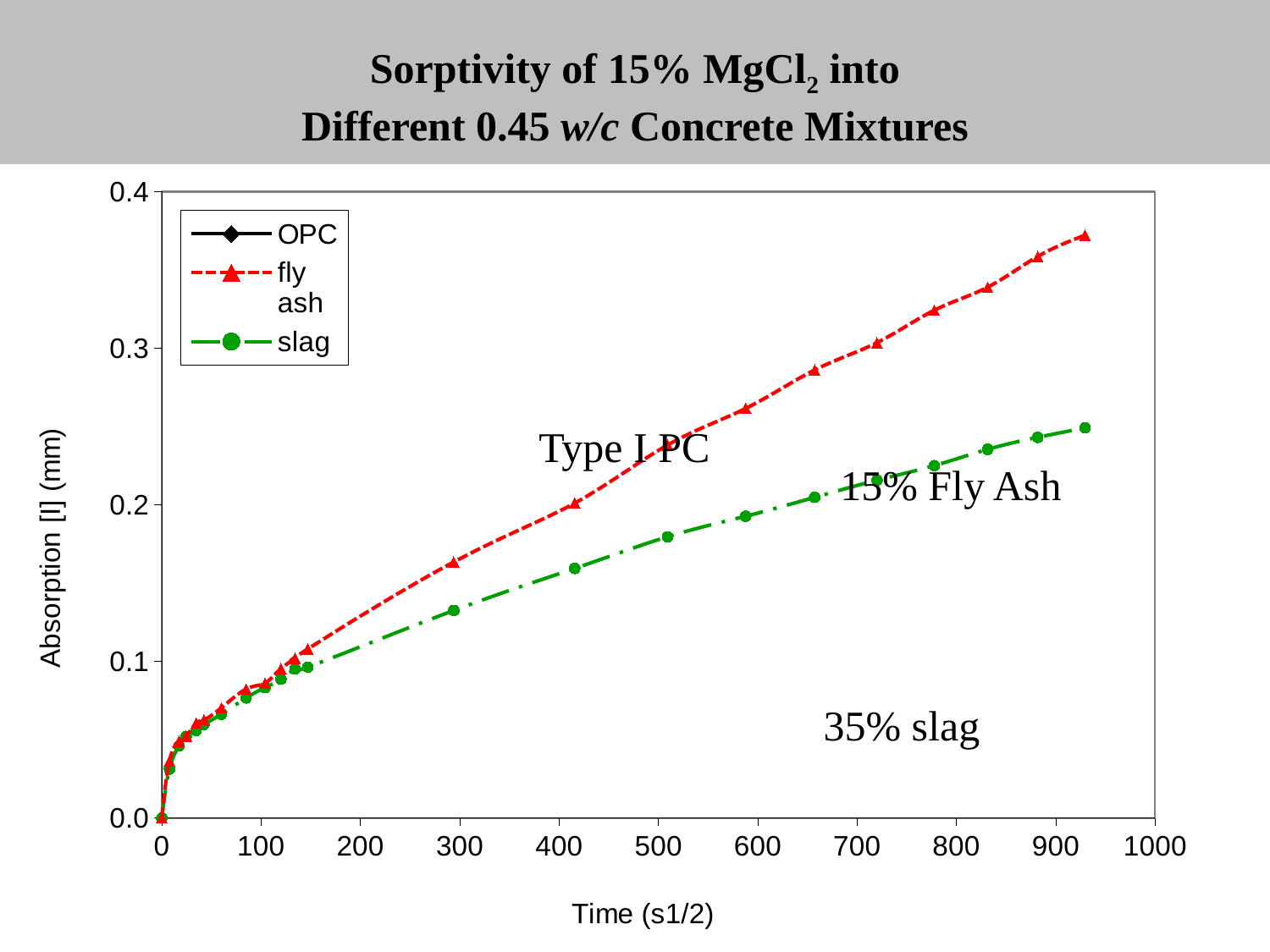
Does the absorption for the fly ash series rise or fall as time increases? rise Is the absorption for the fly ash series at about 290 on the x axis greater or less than 0.2? less What is the label of the y axis? Absorption [I] (mm) Does the absorption for the slag series rise or fall as time increases? rise What kind of chart is shown on the slide? line chart What is the title of the chart? Sorptivity of 15% MgCl2 into Different 0.45 w/c Concrete Mixtures At the right end of the chart (around 930 on the x axis), which series has the higher absorption, fly ash or slag? fly ash Is the absorption for the slag series at about 290 on the x axis greater or less than 0.1? greater Is the final absorption value for the fly ash series greater or less than 0.3? greater How many series does the legend list? 3